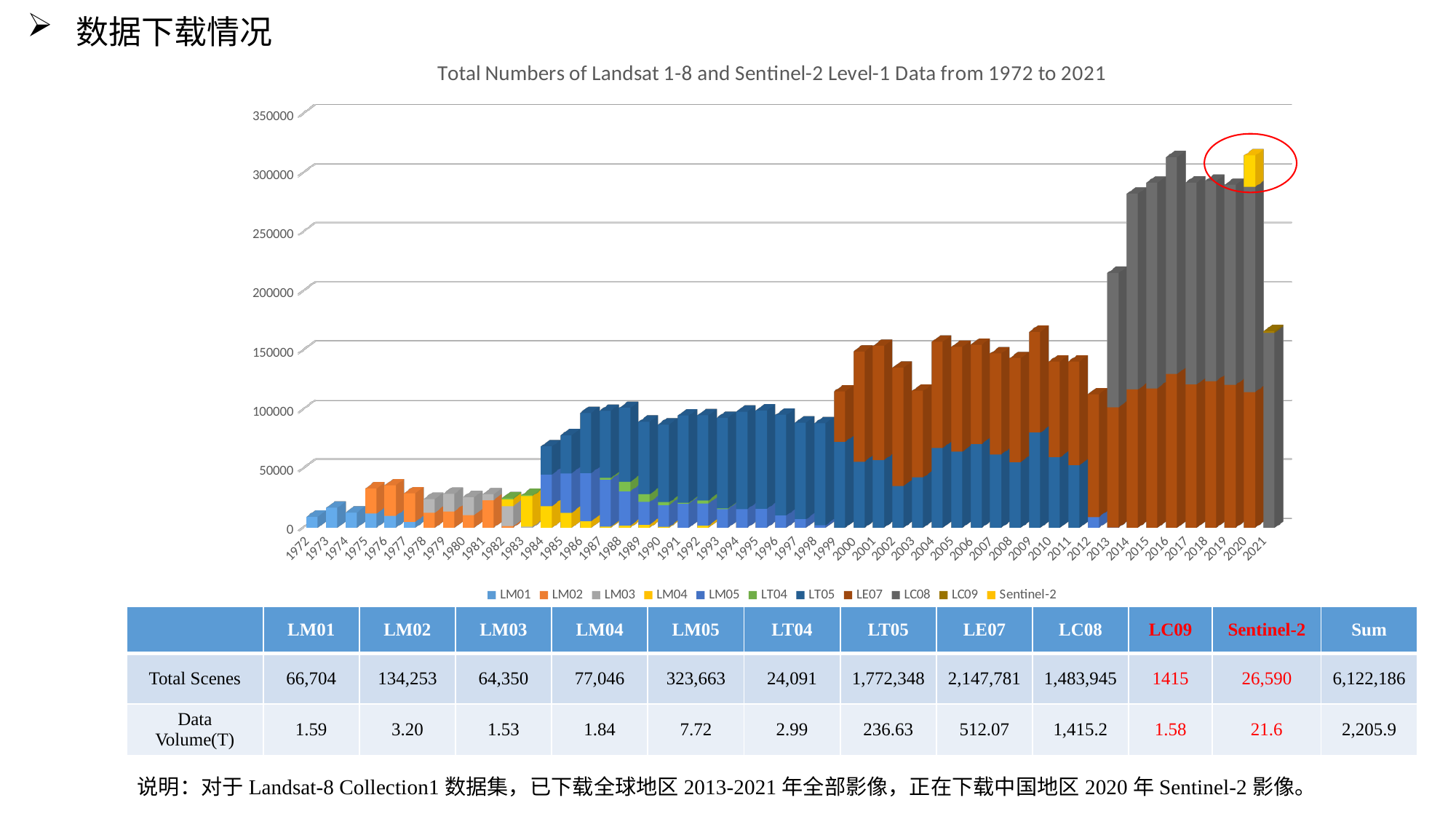
Is the total value of the stacked bar for 2014 greater or less than 250000? greater Is the total value of the stacked bar for 1972 greater or less than 50000? less Is the total value of the stacked bar for 2013 greater or less than 200000? greater What kind of chart is shown on the slide? bar chart How many series does the chart legend list? 11 Which year has the taller stacked bar, 1999 or 2013? 2013 Which year has the taller stacked bar, 2016 or 2021? 2016 How many years are shown along the x axis of the chart? 50 Do the stacked bar totals rise or fall from 2013 to 2016? rise What is the title of the chart? Total Numbers of Landsat 1-8 and Sentinel-2 Level-1 Data from 1972 to 2021